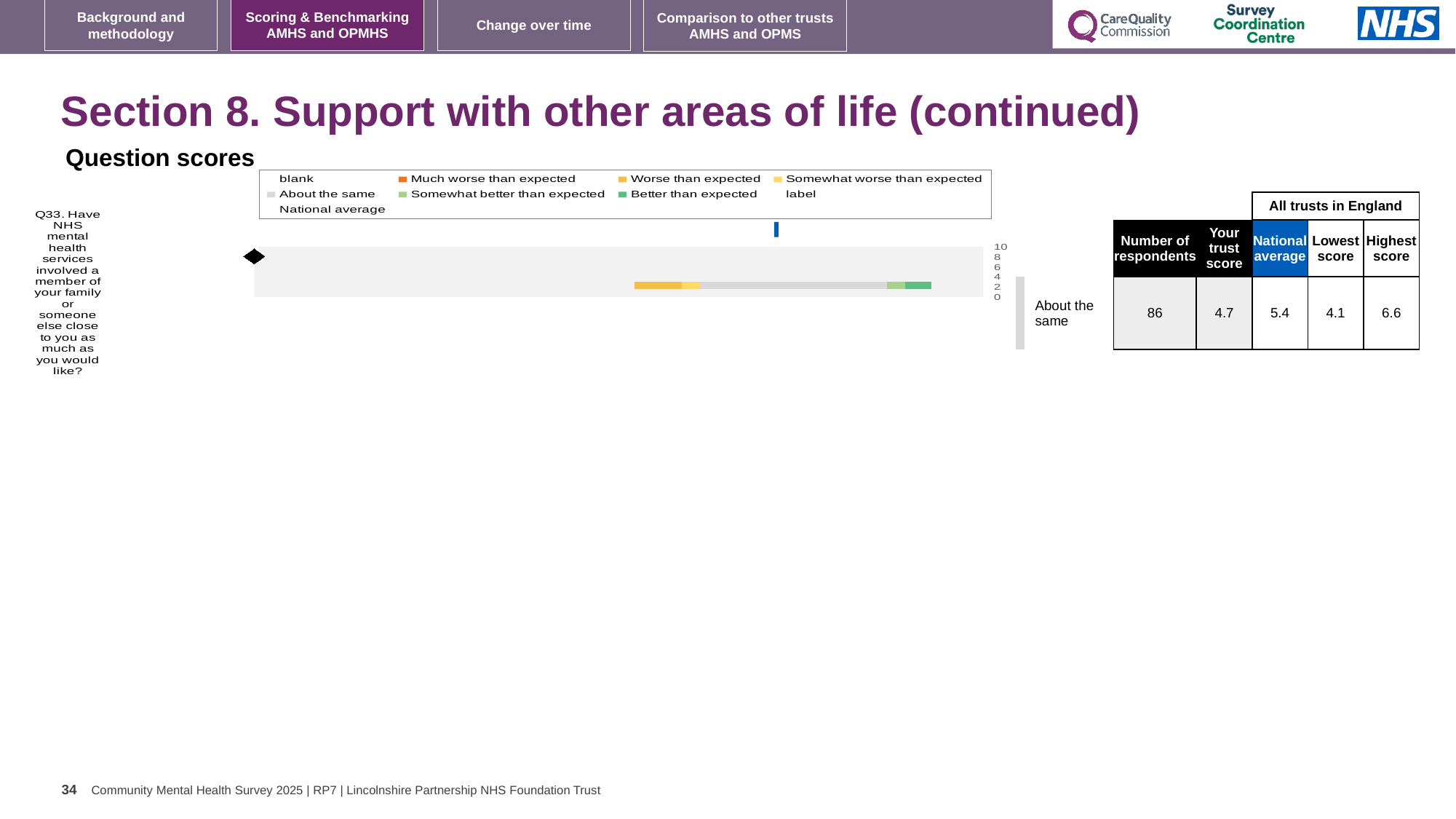
What is the national average score for Q33? 5.4 How many survey questions are plotted in the Question scores chart? 1 How many respondents answered Q33? 86 What is the highest score among all trusts in England for Q33? 6.6 By how much does the national average exceed the trust's score for Q33? 0.7 What is the difference between the highest and lowest scores for Q33 across all trusts in England? 2.5 Which benchmark category is the trust's Q33 score placed in? About the same What is the trust's score for Q33 in the Question scores chart? 4.7 Which is larger for Q33: the trust's score or the national average? National average What is the lowest score among all trusts in England for Q33? 4.1 What kind of chart is shown under 'Question scores'? Bar chart Is the trust's score for Q33 greater or less than 6 on the chart axis? less